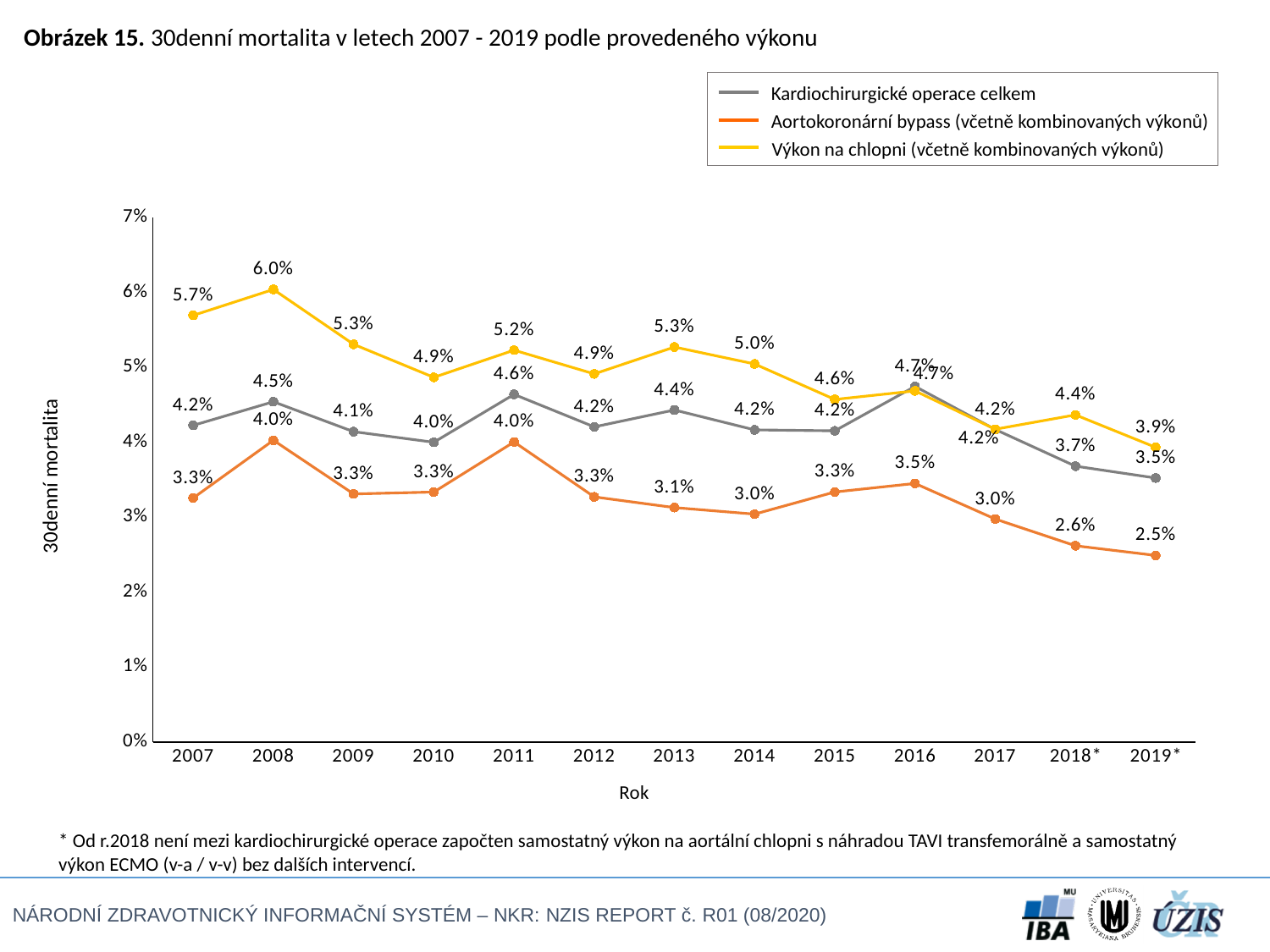
How many years are shown on the x axis? 13 What is the 30-day mortality for Výkon na chlopni (včetně kombinovaných výkonů) in 2008? 6.0% In 2013, which is larger: Kardiochirurgické operace celkem or Aortokoronární bypass? Kardiochirurgické operace celkem Does the value for Aortokoronární bypass rise or fall from 2016 to 2019*? fall In which year is the value for Aortokoronární bypass (včetně kombinovaných výkonů) lowest? 2019* Is the value for Aortokoronární bypass in 2014 greater or less than 4%? less What is the value for Kardiochirurgické operace celkem in 2011? 4.6% What is the value for Aortokoronární bypass (včetně kombinovaných výkonů) in 2019*? 2.5% In which year is the value for Výkon na chlopni (včetně kombinovaných výkonů) highest? 2008 How many series does the legend list? 3 What kind of chart is shown on the slide? line chart What is the difference between Výkon na chlopni and Aortokoronární bypass in 2008? 2.0 percentage points